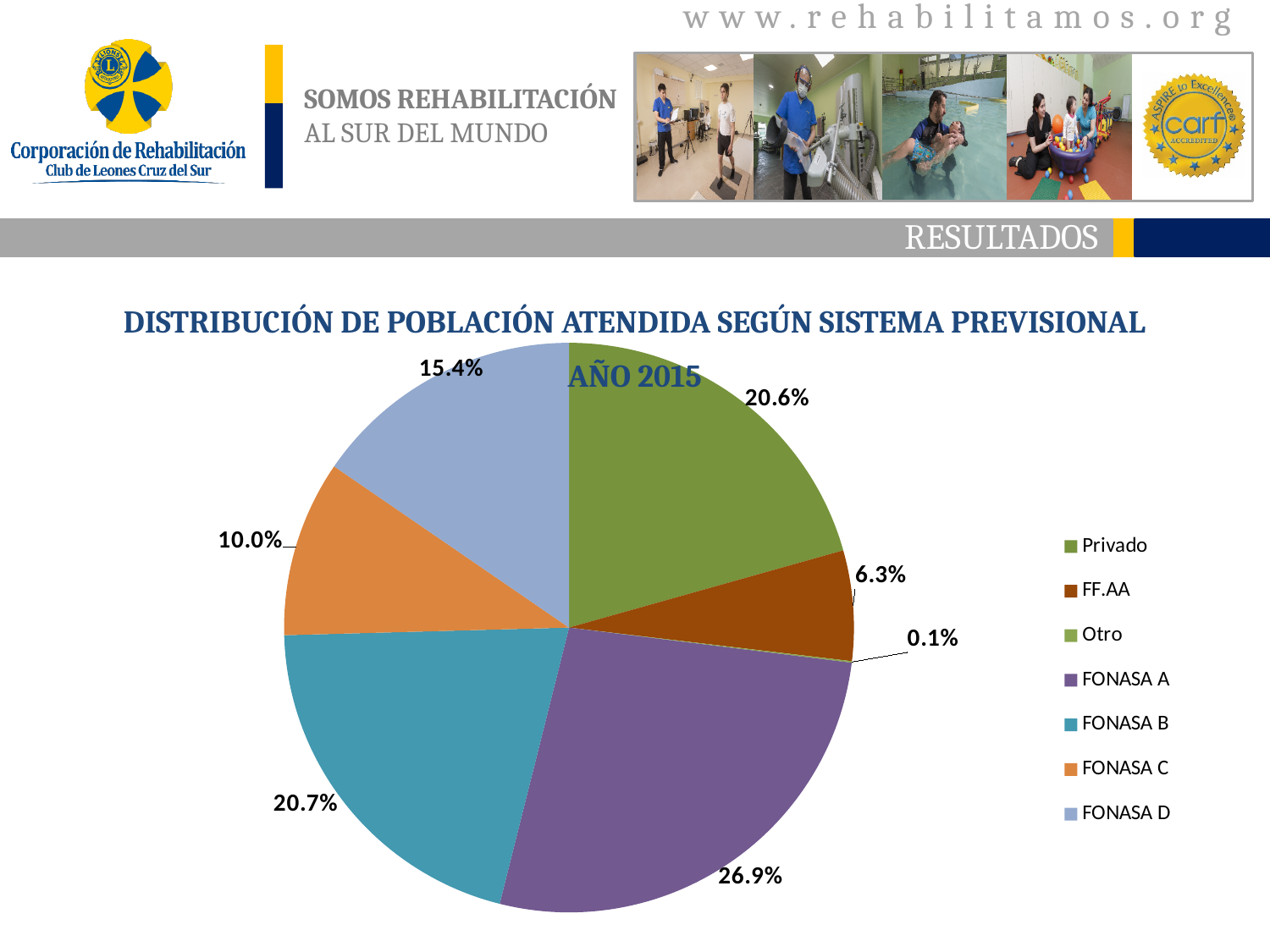
What is the value shown for FF.AA? 6.3% What percentage is shown for FONASA D? 15.4% What kind of chart is shown on the slide? pie chart What share of the population attended is covered by FONASA A? 26.9% What is the difference between the FONASA C share and the FF.AA share? 3.7% Which category has the smallest slice of the pie? Otro How many categories does the legend list? 7 Which is larger, the share for FONASA C or the share for FF.AA? FONASA C What percentage of the pie corresponds to Privado? 20.6% Which category has the largest slice of the pie? FONASA A What is the difference between the FONASA A share and the FONASA D share? 11.5% What year does the chart refer to, according to the label on the chart? 2015